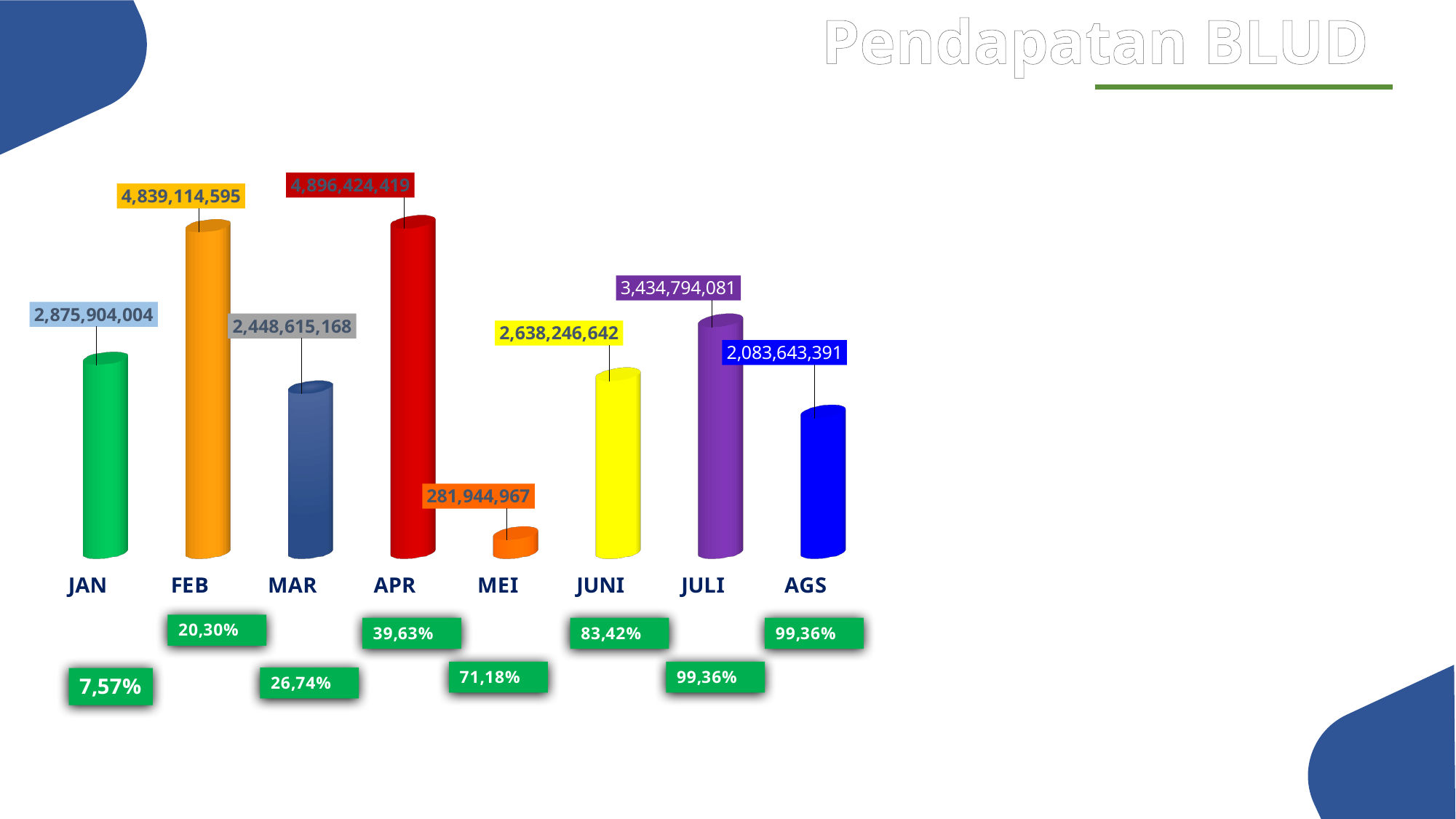
What is the title of the slide? Pendapatan BLUD Which month has the highest value? APR What is the value for JULI? 3,434,794,081 Which is larger, the value for JAN or the value for JUNI? JAN What is the value for FEB? 4,839,114,595 What is the difference between the values for JULI and AGS? 1,351,150,690 Which month has the lowest value? MEI What is the difference between the values for APR and FEB? 57,309,824 What is the value for MEI? 281,944,967 Do the values rise or fall from MEI to JULI? rise What kind of chart is shown on the slide? bar chart How many months are shown in the chart? 8